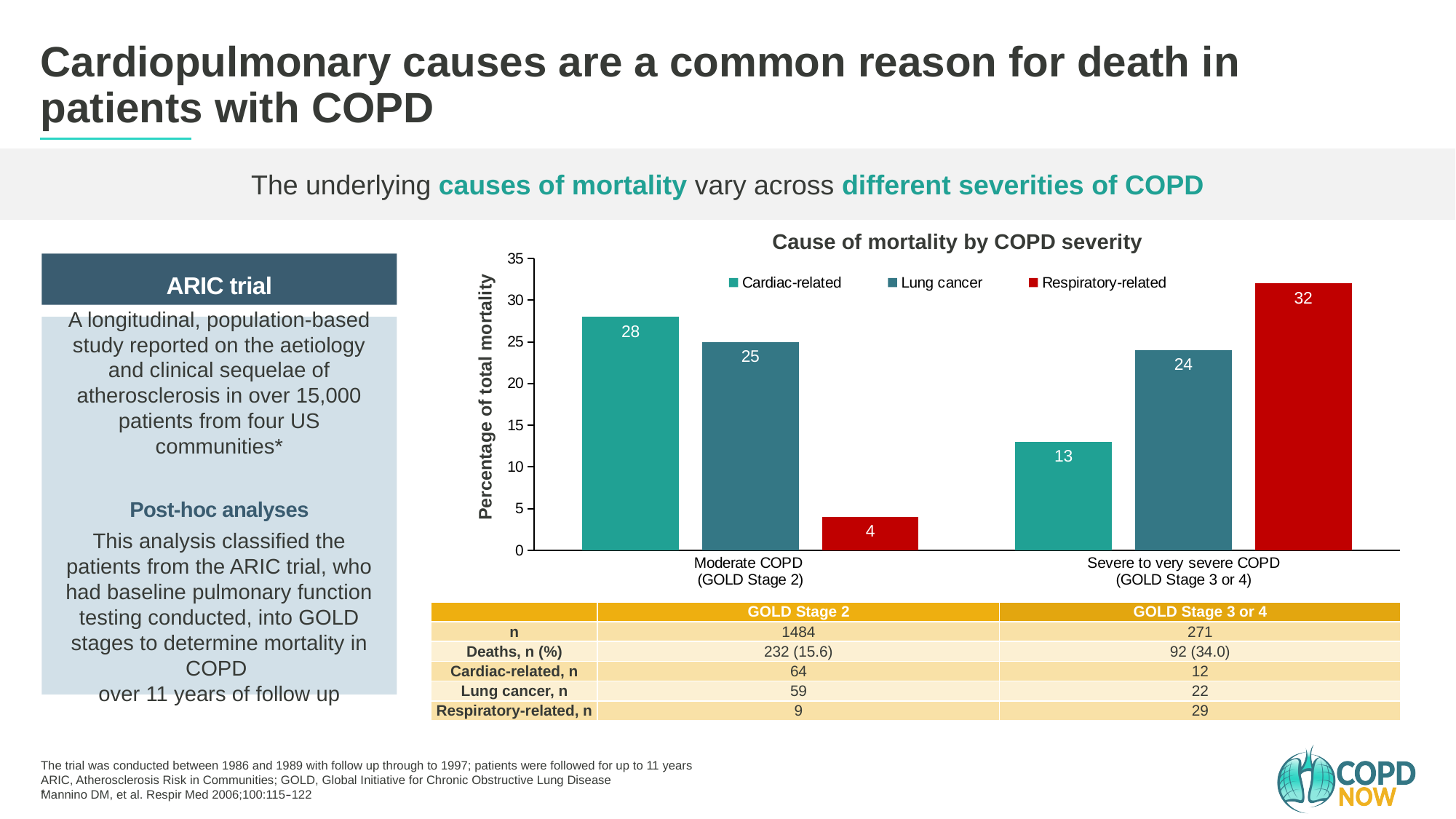
Which is larger: the Cardiac-related value for Moderate COPD or the Cardiac-related value for Severe to very severe COPD? Moderate COPD What is the Cardiac-related value for Moderate COPD (GOLD Stage 2)? 28 What is the title of the chart? Cause of mortality by COPD severity How many COPD severity categories are shown on the x axis? 2 Which cause of mortality has the lowest value for Moderate COPD (GOLD Stage 2)? Respiratory-related What is the difference between the Respiratory-related values for Severe to very severe COPD and Moderate COPD? 28 What is the label of the y axis? Percentage of total mortality What is the Respiratory-related value for Severe to very severe COPD (GOLD Stage 3 or 4)? 32 What is the Lung cancer value for Moderate COPD (GOLD Stage 2)? 25 How many series does the legend list? 3 Which cause of mortality has the highest value for Severe to very severe COPD (GOLD Stage 3 or 4)? Respiratory-related What kind of chart is shown? Bar chart